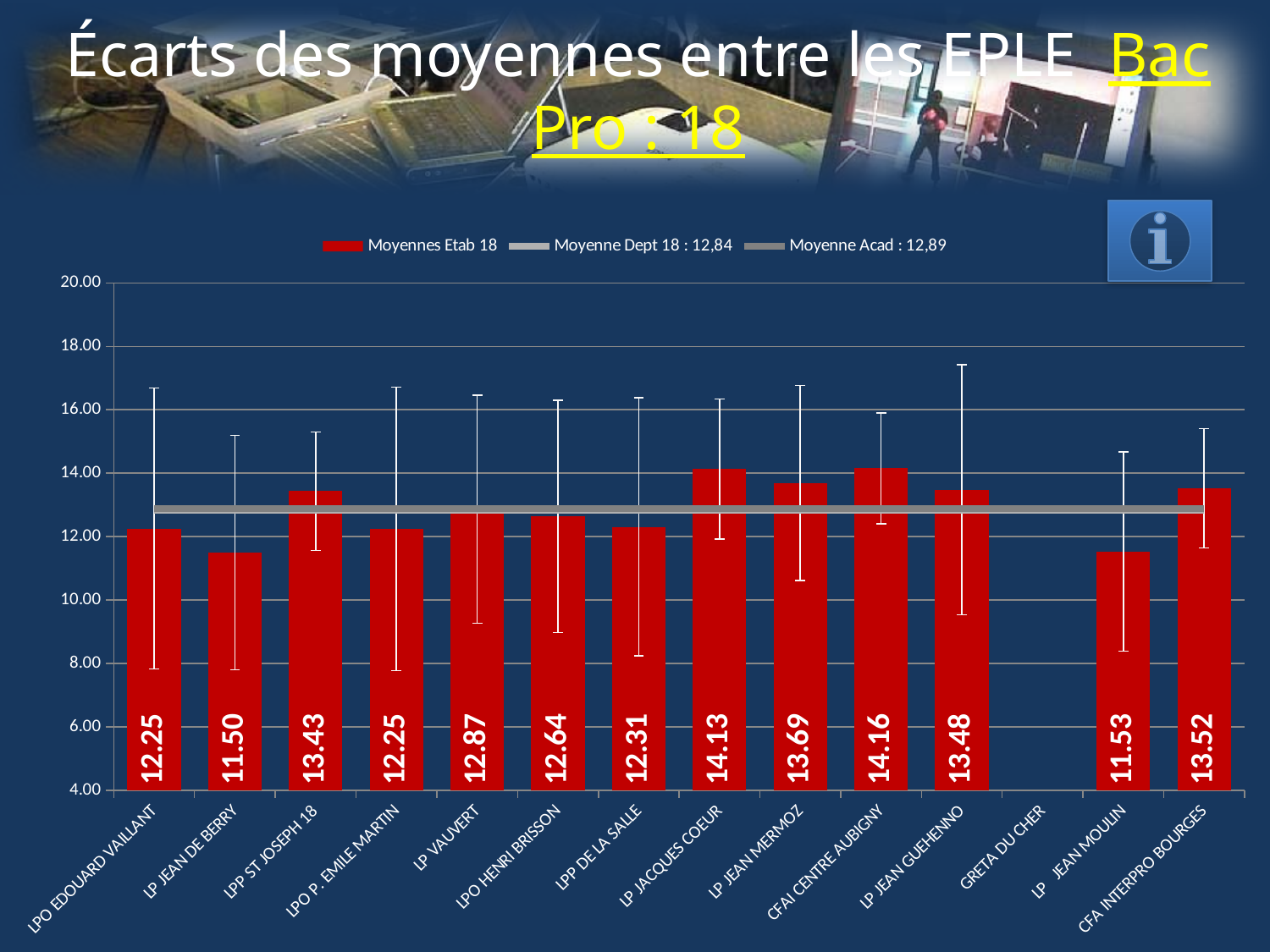
What is the value for CFAI CENTRE AUBIGNY? 14.16 Is the value for LP JEAN DE BERRY greater or less than 12.00? less Which establishment has the lowest value? LP JEAN DE BERRY What kind of chart is shown on the slide? bar chart Which is larger, the value for LPP ST JOSEPH 18 or the value for LP VAUVERT? LPP ST JOSEPH 18 What is the value for LP JEAN MOULIN? 11.53 What is the value for LP VAUVERT? 12.87 Which establishment has the highest value? CFAI CENTRE AUBIGNY What is the difference between the values for CFAI CENTRE AUBIGNY and LP JEAN DE BERRY? 2.66 How many establishments are labeled on the x axis? 14 How many series does the legend list? 3 What value does the legend give for Moyenne Dept 18? 12,84